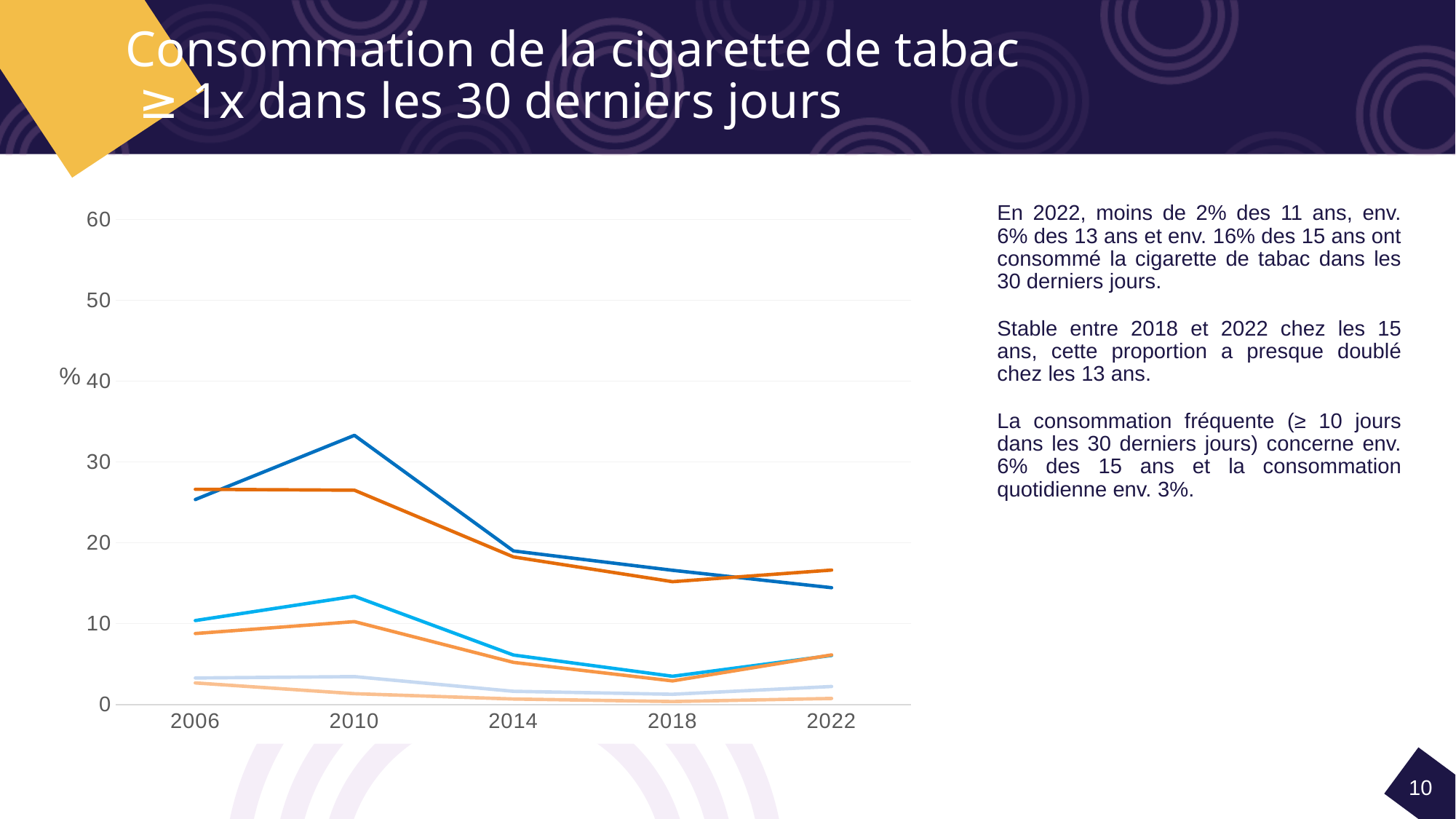
Is the highest value plotted in 2018 greater or less than 20? less How many lines are plotted on the chart? 6 What is the first year shown on the x axis of the chart? 2006 What is the last year shown on the x axis of the chart? 2022 Is the highest value plotted in 2022 greater or less than 20? less How many years are shown on the x axis of the chart? 5 What kind of chart is shown on the slide? line chart Is the highest value plotted in 2010 greater or less than 30? greater Do the values of the two upper lines rise or fall between 2010 and 2018? fall In which year does the topmost line reach its peak? 2010